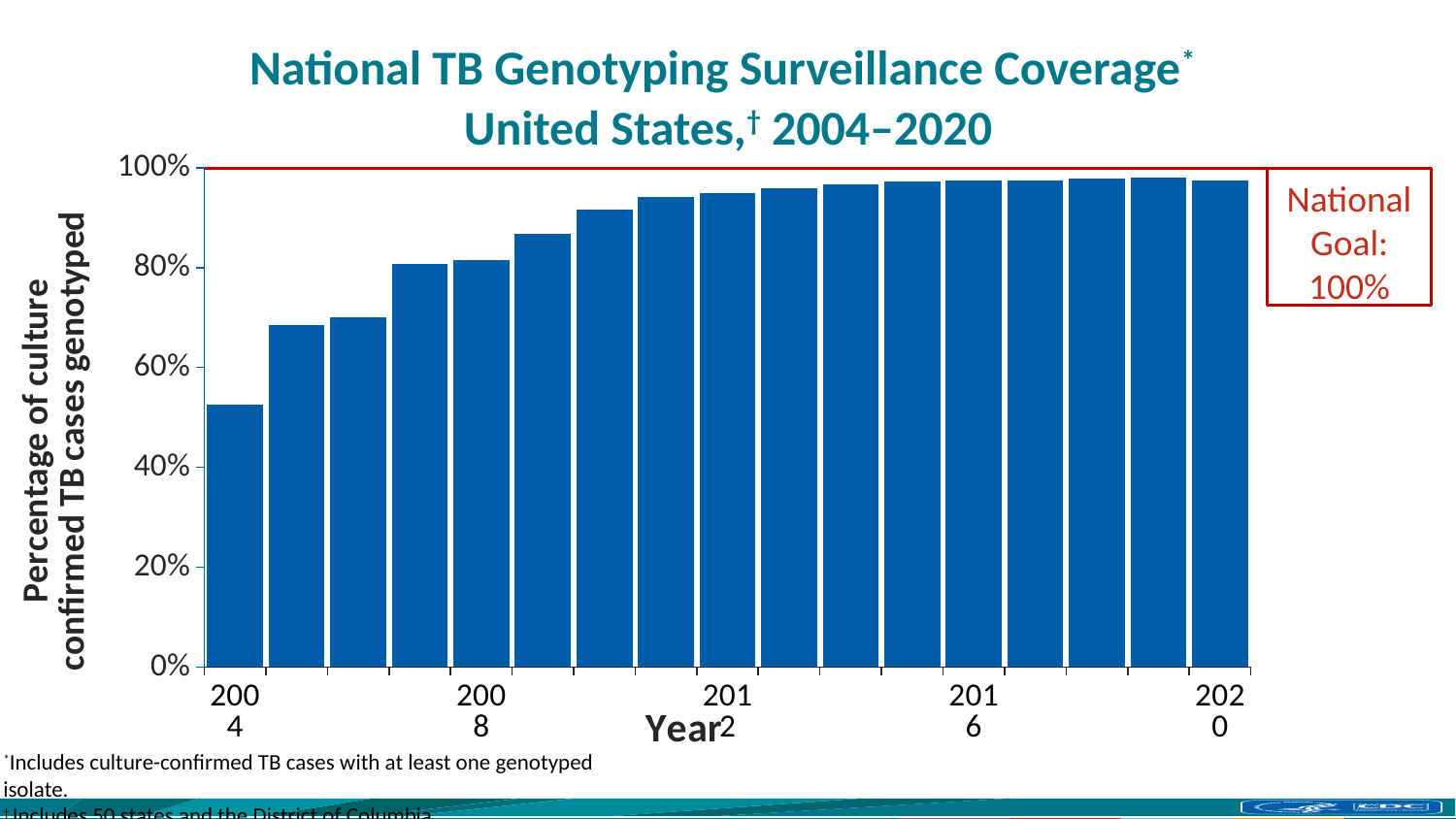
What is the label of the x axis? Year Is the value for 2020 greater or less than 80%? greater Is the value for 2012 greater or less than 80%? greater Which year has a higher value, 2008 or 2016? 2016 Do the values generally rise or fall from 2004 to 2020? rise What kind of chart is shown on the slide? bar chart Which year has the lowest percentage of culture-confirmed TB cases genotyped? 2004 Which year has a higher value, 2004 or 2020? 2020 Is the value for 2004 greater or less than 40%? greater How many bars (years) are plotted in the chart? 17 What is the National Goal shown in the red box on the chart? 100%